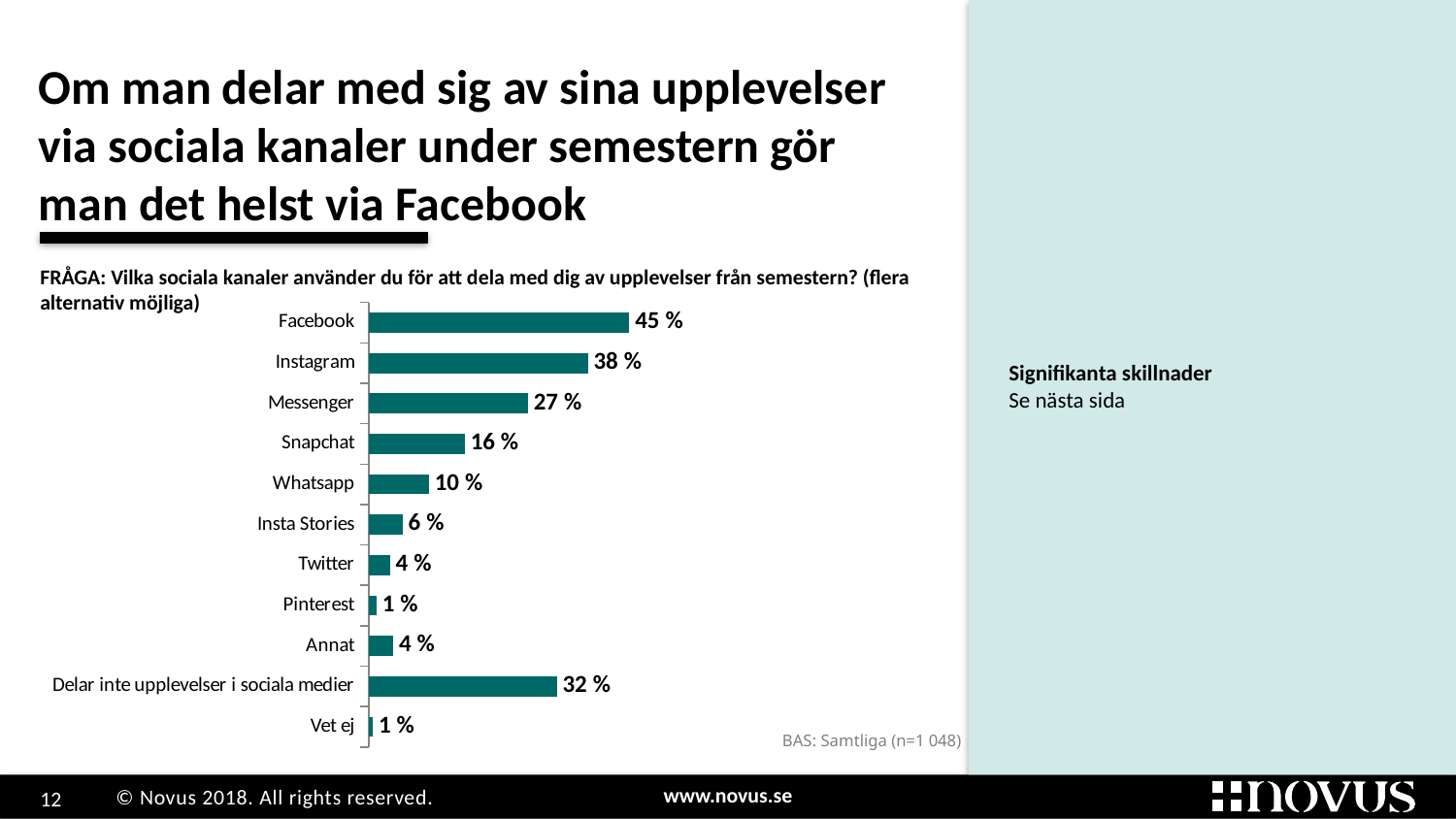
What is the value for Instagram? 38 % What is the difference between the values for Messenger and Snapchat? 11 % What is the value for Delar inte upplevelser i sociala medier? 32 % Which category has the highest value? Facebook What is the base (BAS) sample size noted on the chart? n=1 048 Which is larger, the value for Messenger or the value for Delar inte upplevelser i sociala medier? Delar inte upplevelser i sociala medier How many categories are shown in the chart? 11 Which is larger, the value for Snapchat or the value for Whatsapp? Snapchat What kind of chart is shown on the slide? Bar chart What is the value for Whatsapp? 10 % What is the difference between the values for Facebook and Instagram? 7 % What is the value for Facebook? 45 %